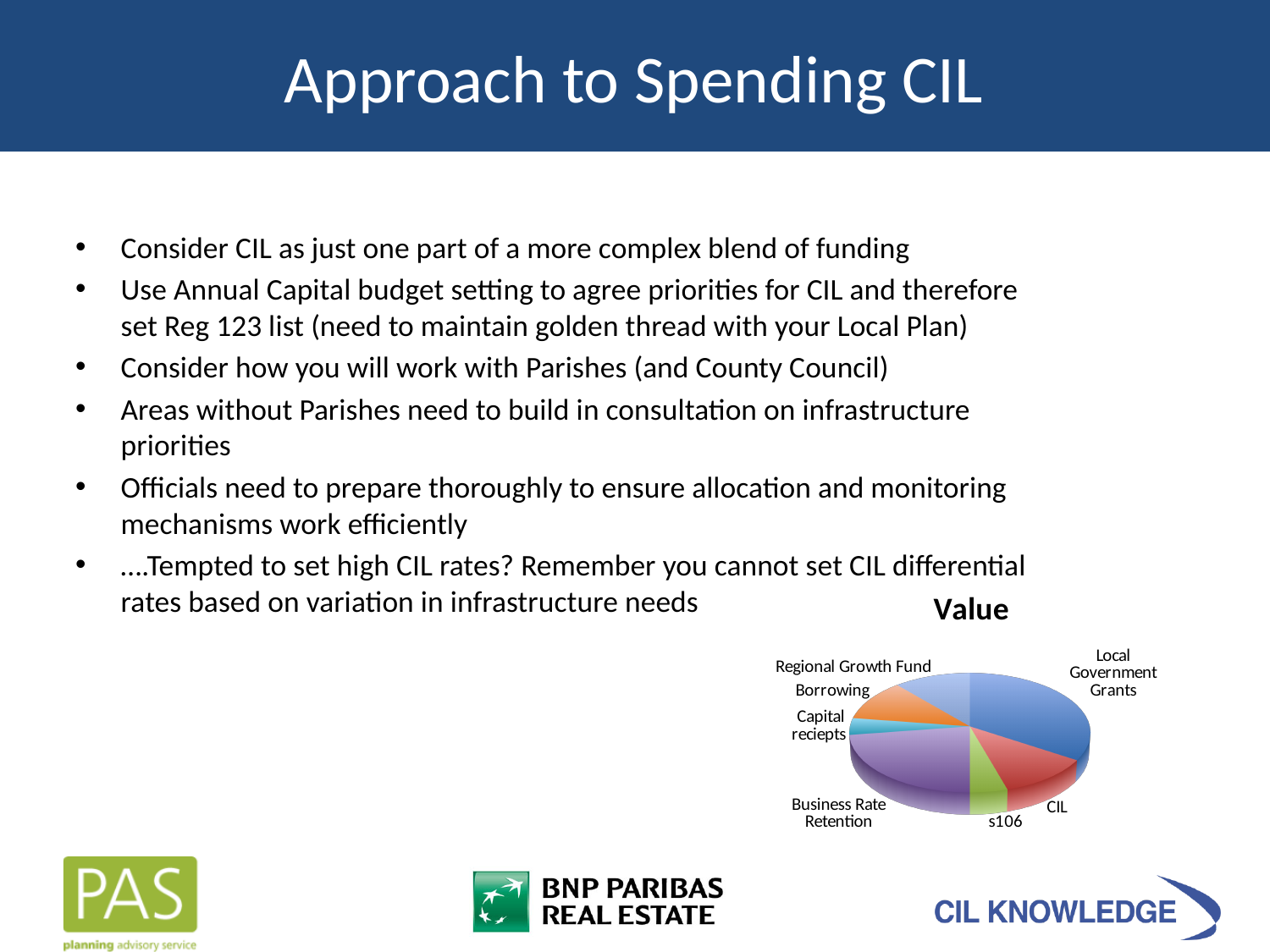
Which is larger in the pie chart, Regional Growth Fund or Capital reciepts? Regional Growth Fund Which is larger in the pie chart, Borrowing or Capital reciepts? Borrowing What kind of chart is shown on the slide? pie chart How many slices does the pie chart have? 7 Which slice of the pie chart is coloured green? s106 Which is larger in the pie chart, CIL or s106? CIL What is the title of the pie chart? Value